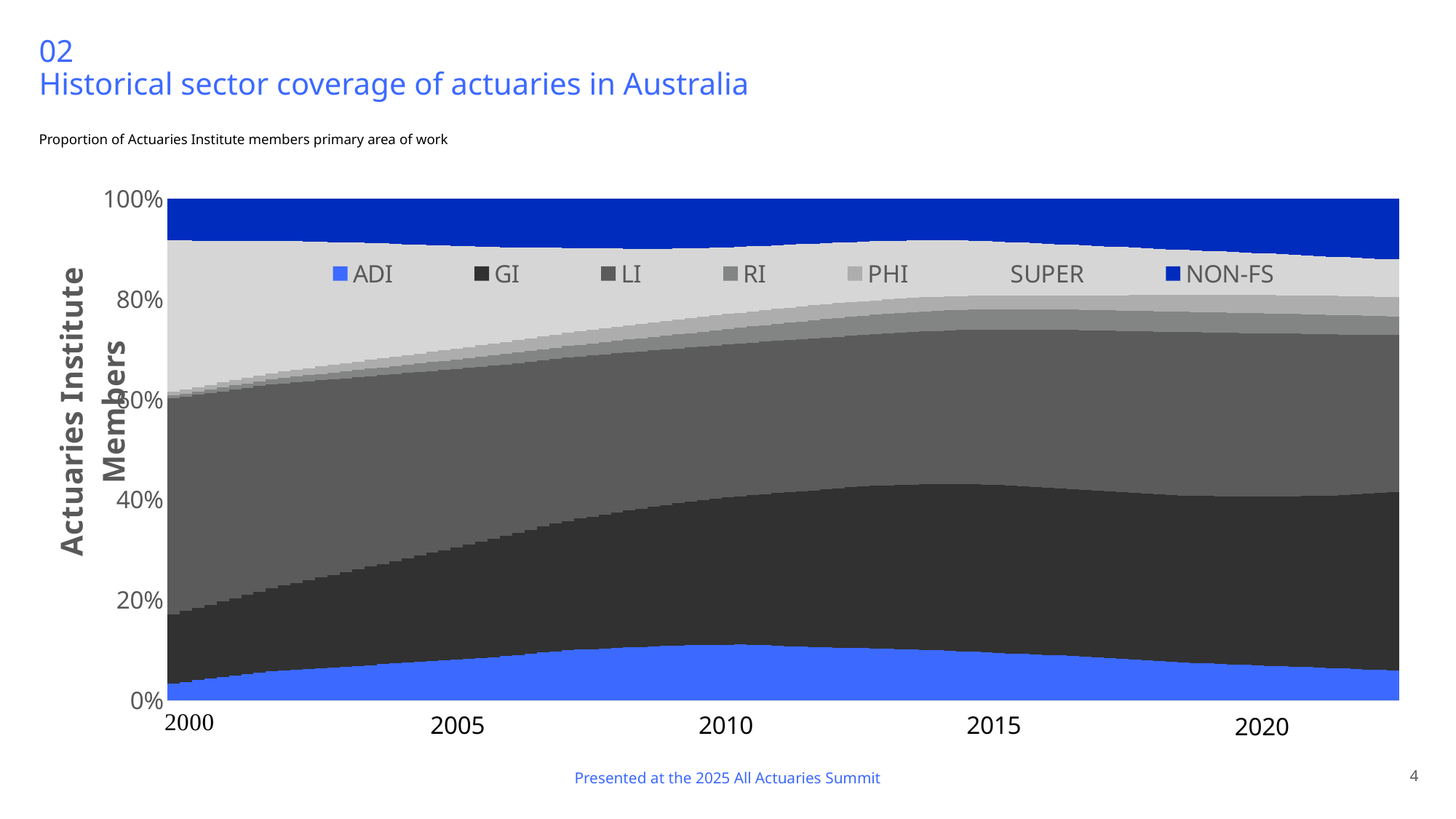
In 2000, which sector has the largest share of members? LI Which series is shown in dark blue at the top of the chart? NON-FS What is the highest value labelled on the y axis? 100% Is the value for ADI in 2000 greater or less than 20%? less What kind of chart is shown on the slide? 100% stacked bar chart What is the first year labelled on the x axis? 2000 Is the value for ADI in 2010 greater or less than 20%? less Does the share of GI rise or fall between 2000 and 2015? rise What is the title of the slide containing the chart? Historical sector coverage of actuaries in Australia How many series does the chart legend list? 7 Does the share of SUPER rise or fall between 2000 and 2020? fall In 2000, which has the larger share: SUPER or GI? SUPER